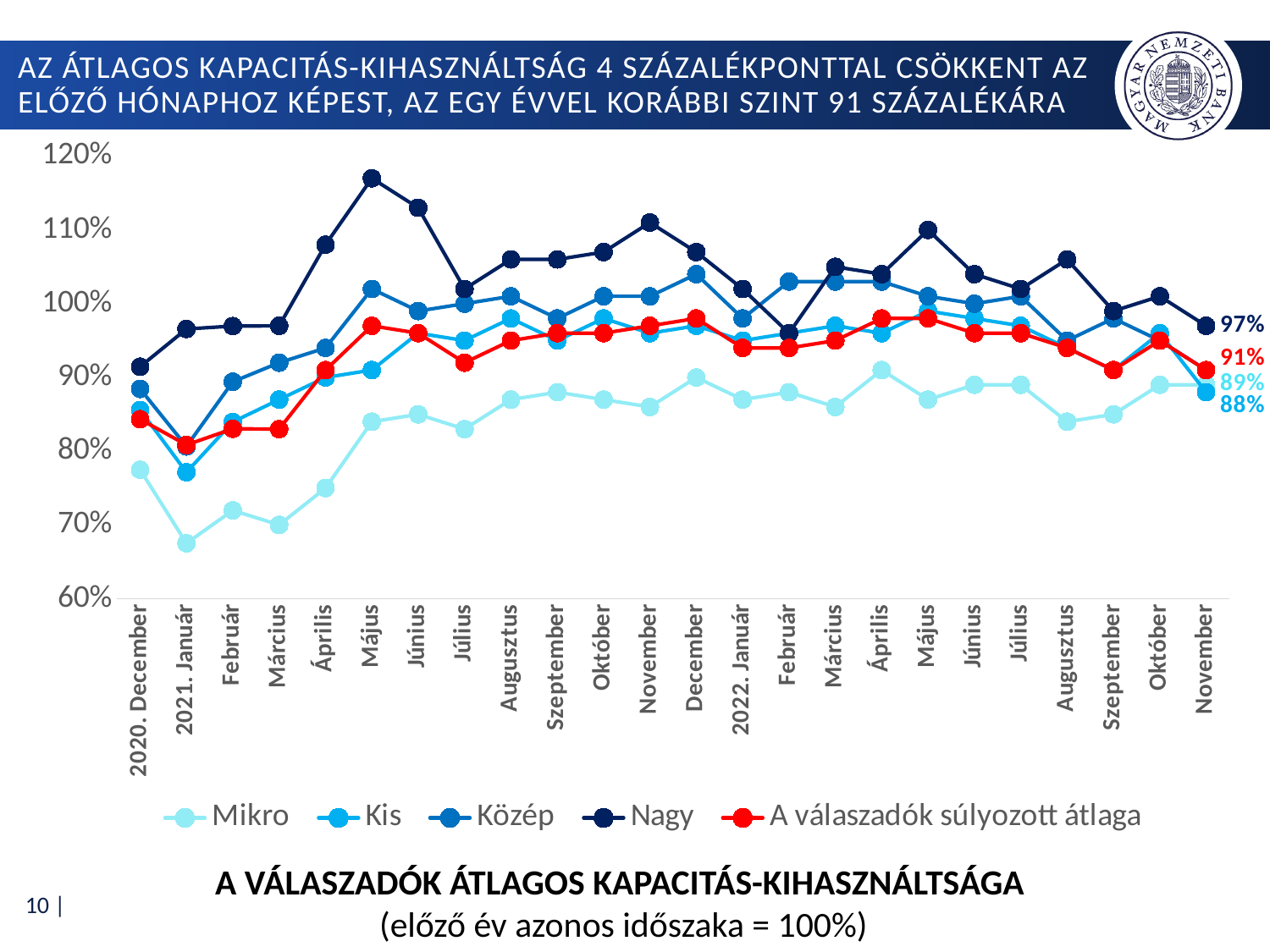
What is the difference between the labelled November 2022 values for Nagy (97%) and 'A válaszadók súlyozott átlaga' (91%)? 6 percentage points What is the value for Nagy in November 2022, as labelled at the end of the line? 97% How many series does the legend list? 5 Which series has the highest value in 2021 Május? Nagy Which is larger in 2021 Május: the value for Nagy or the value for Mikro? Nagy How many months are shown on the x axis? 24 Does the Mikro line rise or fall from 2020. December to 2021. Január? fall Is the value for Mikro in 2021 Január greater or less than 70%? less What kind of chart is shown on the slide? line chart Which series has the lowest value in 2021 Január? Mikro Is the value for Nagy in 2021 Május greater or less than 110%? greater What is the value for 'A válaszadók súlyozott átlaga' in November 2022, as labelled at the end of the line? 91%